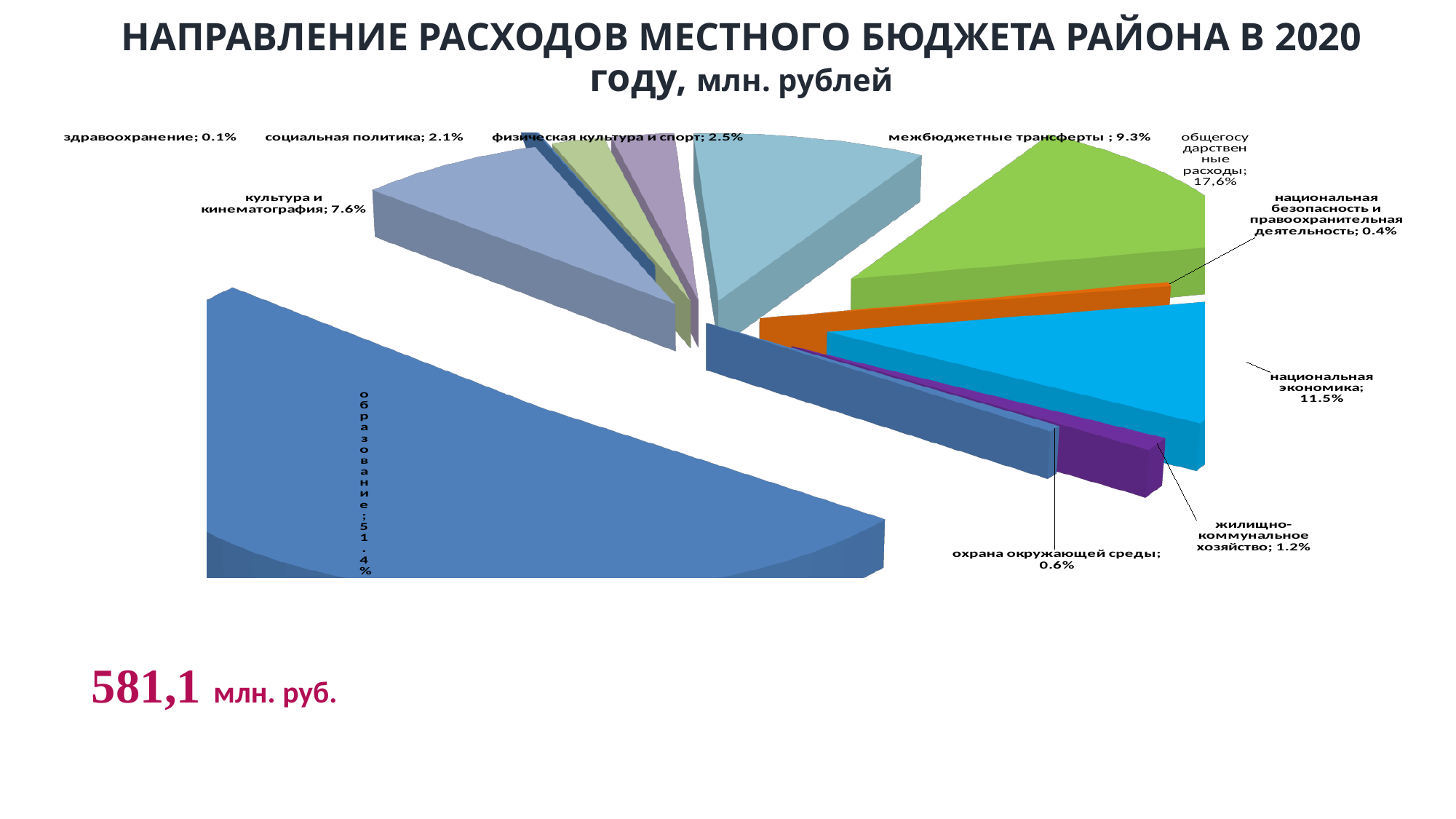
What kind of chart is shown on the slide? pie chart What share of the budget expenditure goes to образование? 51.4% What share is shown for национальная экономика? 11.5% Which category has the smallest share of the budget expenditure? здравоохранение Which has a larger share: социальная политика or физическая культура и спорт? физическая культура и спорт Which category has the largest share of the budget expenditure? образование What share is shown for межбюджетные трансферты? 9.3% What is the difference in percentage points between общегосударственные расходы and национальная экономика? 6.1 What share is shown for культура и кинематография? 7.6% What total amount of expenditure is stated on the slide? 581,1 млн. руб. What share is shown for общегосударственные расходы? 17,6% How many categories are shown in the pie chart? 11